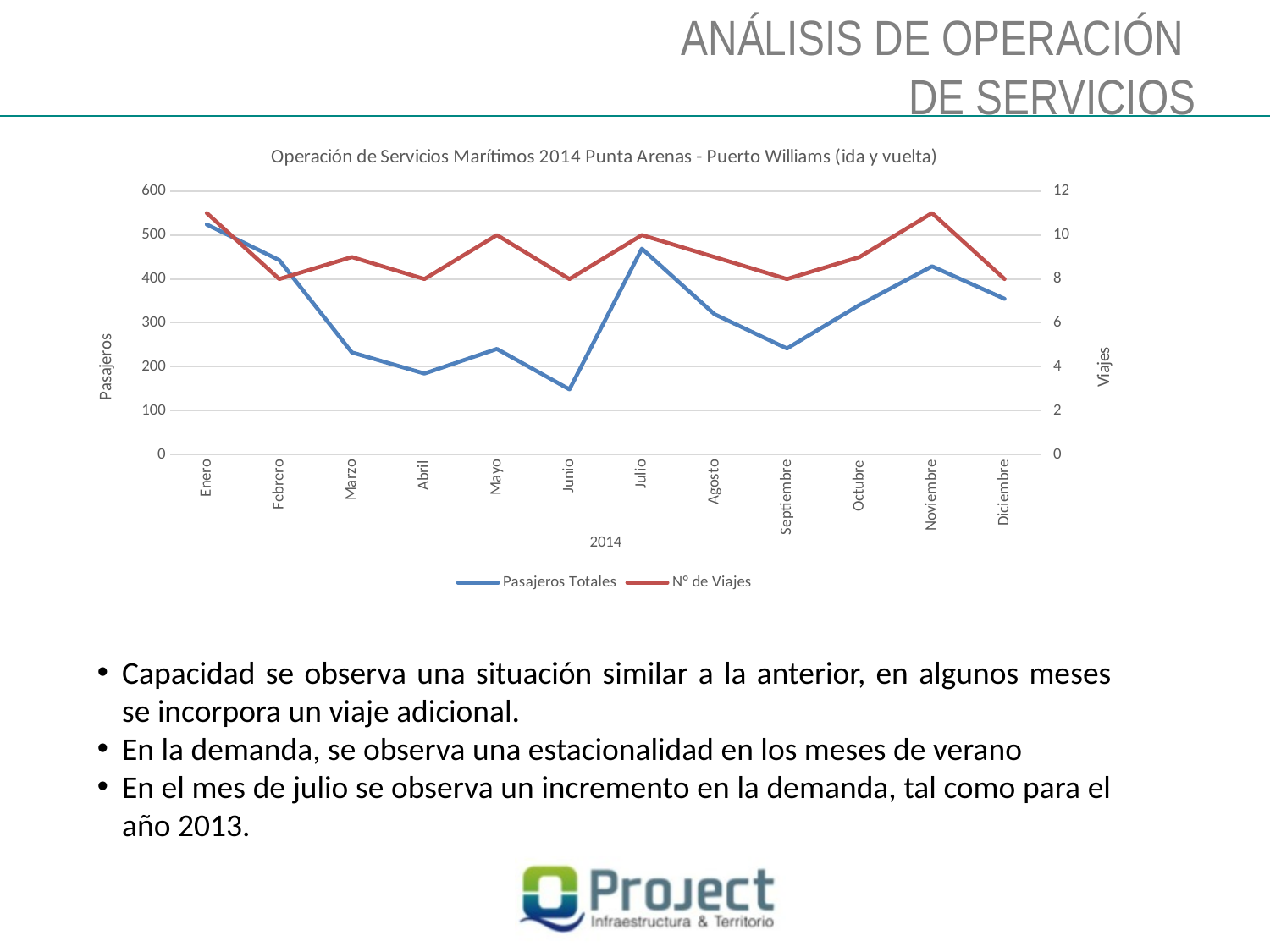
Which month has more Pasajeros Totales, Julio or Agosto? Julio What is the value of N° de Viajes for Diciembre? 8 What kind of chart is shown on the slide? line chart Is the value of Pasajeros Totales for Junio greater or less than 200? less Is the value of Pasajeros Totales for Enero greater or less than 500? greater What is the value of N° de Viajes for Mayo? 10 What is the title of the chart? Operación de Servicios Marítimos 2014 Punta Arenas - Puerto Williams (ida y vuelta) What is the value of N° de Viajes for Febrero? 8 How many months are plotted along the x axis of the chart? 12 How many series does the chart legend list? 2 Which month has the highest value for Pasajeros Totales? Enero Which month has the lowest value for Pasajeros Totales? Junio